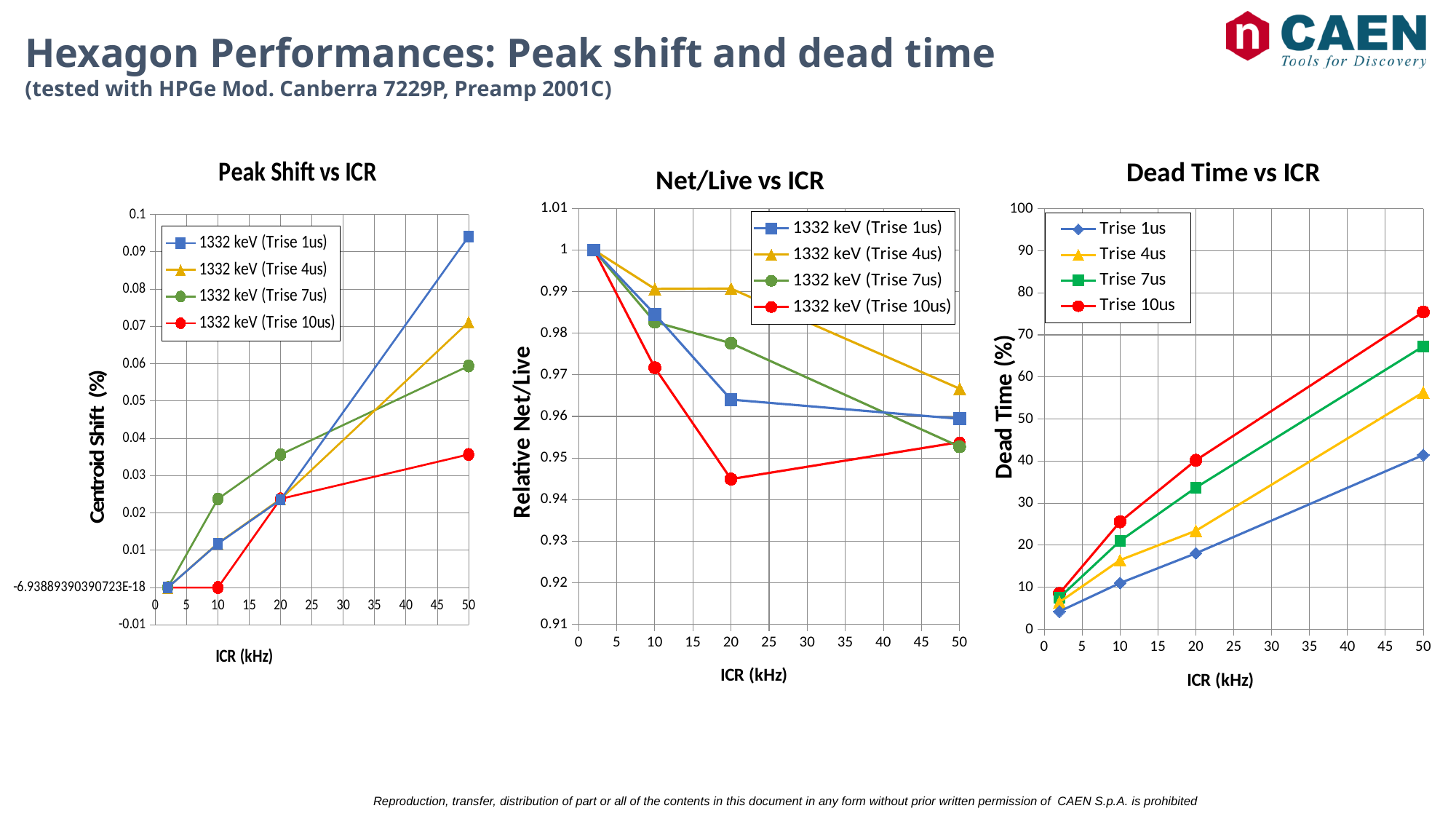
In the "Dead Time vs ICR" chart, is the value for Trise 1us at 50 kHz greater or less than 50? less In the "Peak Shift vs ICR" chart, which series has the lowest centroid shift at 50 kHz? 1332 keV (Trise 10us) In the "Dead Time vs ICR" chart, at 20 kHz, which is larger: Trise 7us or Trise 4us? Trise 7us In the "Dead Time vs ICR" chart, which series has the highest dead time at 50 kHz? Trise 10us In the "Peak Shift vs ICR" chart, is the value for 1332 keV (Trise 1us) at 50 kHz greater or less than 0.08? greater How many series does the legend of the "Net/Live vs ICR" chart list? 4 What is the y-axis title of the "Dead Time vs ICR" chart? Dead Time (%) In the "Dead Time vs ICR" chart, how many data points does the Trise 10us series have? 4 In the "Net/Live vs ICR" chart, do the values generally rise or fall as ICR increases? fall In the "Net/Live vs ICR" chart, which series has the lowest relative Net/Live at 20 kHz? 1332 keV (Trise 10us) In the "Peak Shift vs ICR" chart, which series has the highest centroid shift at 50 kHz? 1332 keV (Trise 1us) What kind of chart is the "Peak Shift vs ICR" chart? line chart